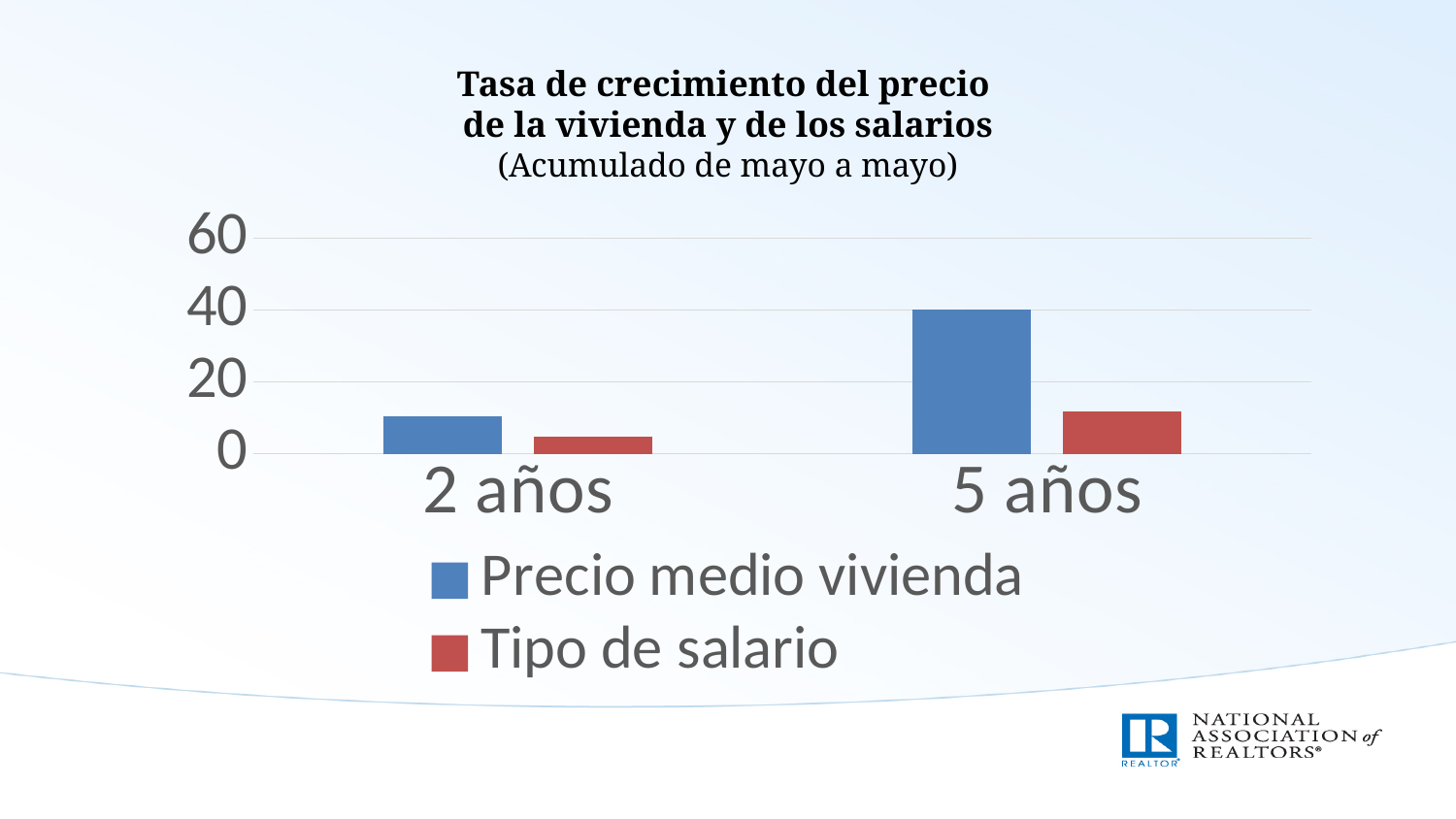
What colour are the bars for Tipo de salario? Red Which category has the higher value for Precio medio vivienda? 5 años Which bar is the lowest in the whole chart? Tipo de salario at 2 años For 5 años, which is larger: Precio medio vivienda or Tipo de salario? Precio medio vivienda For 2 años, which is larger: Precio medio vivienda or Tipo de salario? Precio medio vivienda Does the value for Precio medio vivienda rise or fall from 2 años to 5 años? Rises Is the value for Precio medio vivienda at 5 años greater or less than 20? greater Is the value for Tipo de salario at 5 años greater or less than 20? less What kind of chart is shown on the slide? Bar chart Is the value for Precio medio vivienda at 2 años greater or less than 20? less How many categories are shown on the x axis of the chart? 2 How many series does the chart's legend list? 2